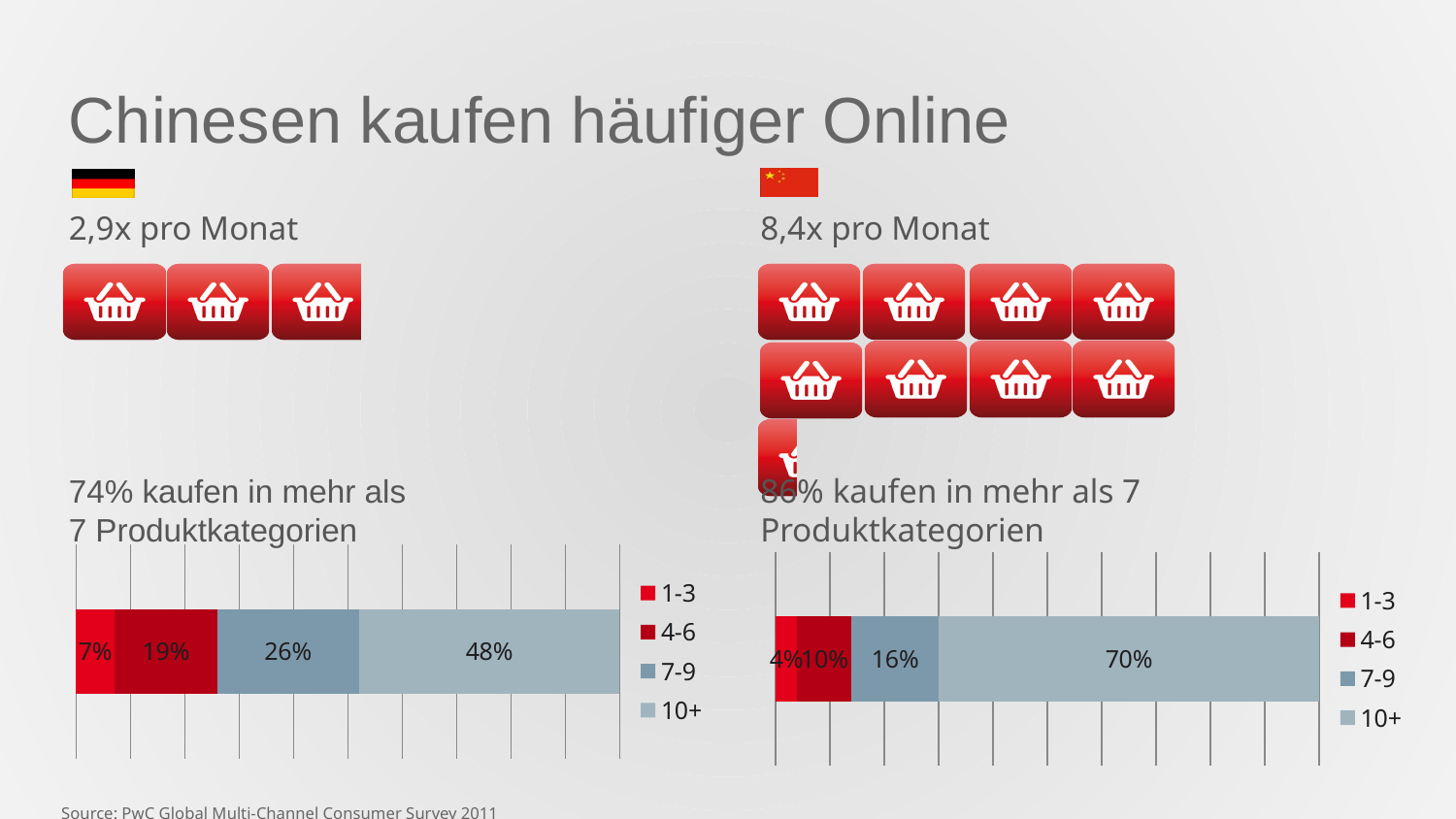
In the right chart (China), which category has the largest share? 10+ In the left chart (Germany), what is the value for the 7-9 category? 26% What are the four legend entries shown next to the right chart (China)? 1-3, 4-6, 7-9, 10+ In the left chart (Germany), what is the total of the 1-3 and 4-6 segments? 26% What type of chart is used on the slide to show the product category shares? Stacked bar chart What is the difference between the 10+ share in the right chart (China) and the 10+ share in the left chart (Germany)? 22% In the left chart (Germany), which category has the smallest share? 1-3 In the left chart (Germany), what share of shoppers buy in 10+ product categories? 48% In the right chart (China), what is the value for the 4-6 category? 10% Which is larger: the 7-9 share in the left chart (Germany) or the 7-9 share in the right chart (China)? Left chart (Germany), 26% How many series does the legend of the left chart (Germany) list? 4 In the right chart (China), what share of shoppers buy in 10+ product categories? 70%